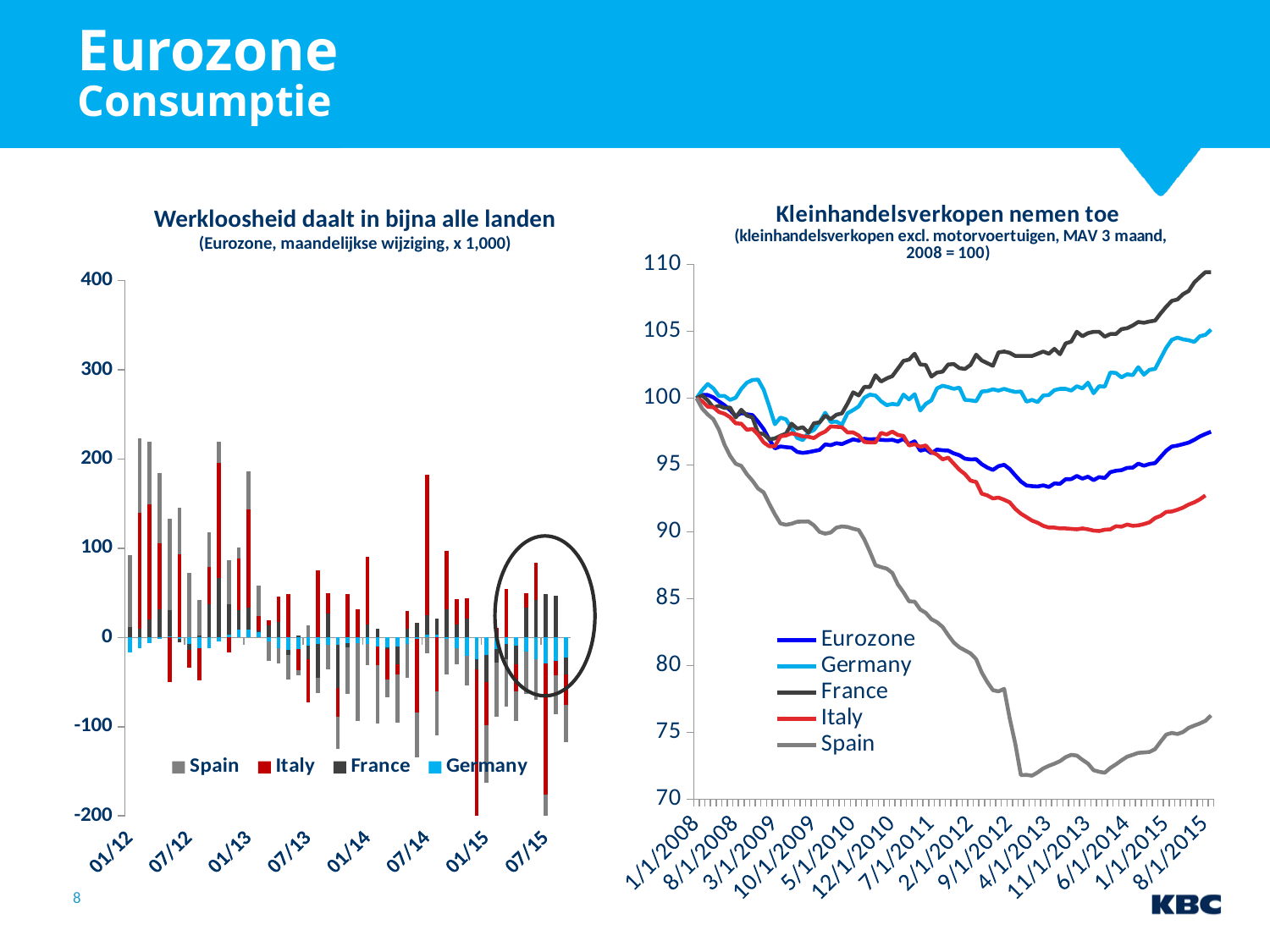
In the right chart 'Kleinhandelsverkopen nemen toe', is the value for France at 8/1/2015 greater or less than 105? greater How many series does the legend of the left chart 'Werkloosheid daalt in bijna alle landen' list? 4 What kind of chart is the left chart titled 'Werkloosheid daalt in bijna alle landen'? bar chart In the right chart 'Kleinhandelsverkopen nemen toe', is the value for Spain at 8/1/2015 greater or less than 80? less In the right chart 'Kleinhandelsverkopen nemen toe', which country has the highest value at the end of the series (8/1/2015)? France How many series does the legend of the right chart 'Kleinhandelsverkopen nemen toe' list? 5 In the right chart 'Kleinhandelsverkopen nemen toe', which is larger at 8/1/2015: Germany or Eurozone? Germany In the right chart 'Kleinhandelsverkopen nemen toe', does the Spain line overall rise or fall from 1/1/2008 to 8/1/2015? fall In the right chart 'Kleinhandelsverkopen nemen toe', what colour is the line for Spain? grey In the right chart 'Kleinhandelsverkopen nemen toe', which country has the lowest value at the end of the series (8/1/2015)? Spain What kind of chart is the right chart titled 'Kleinhandelsverkopen nemen toe'? line chart In the right chart 'Kleinhandelsverkopen nemen toe', is the value for Italy at 8/1/2015 greater or less than 95? less